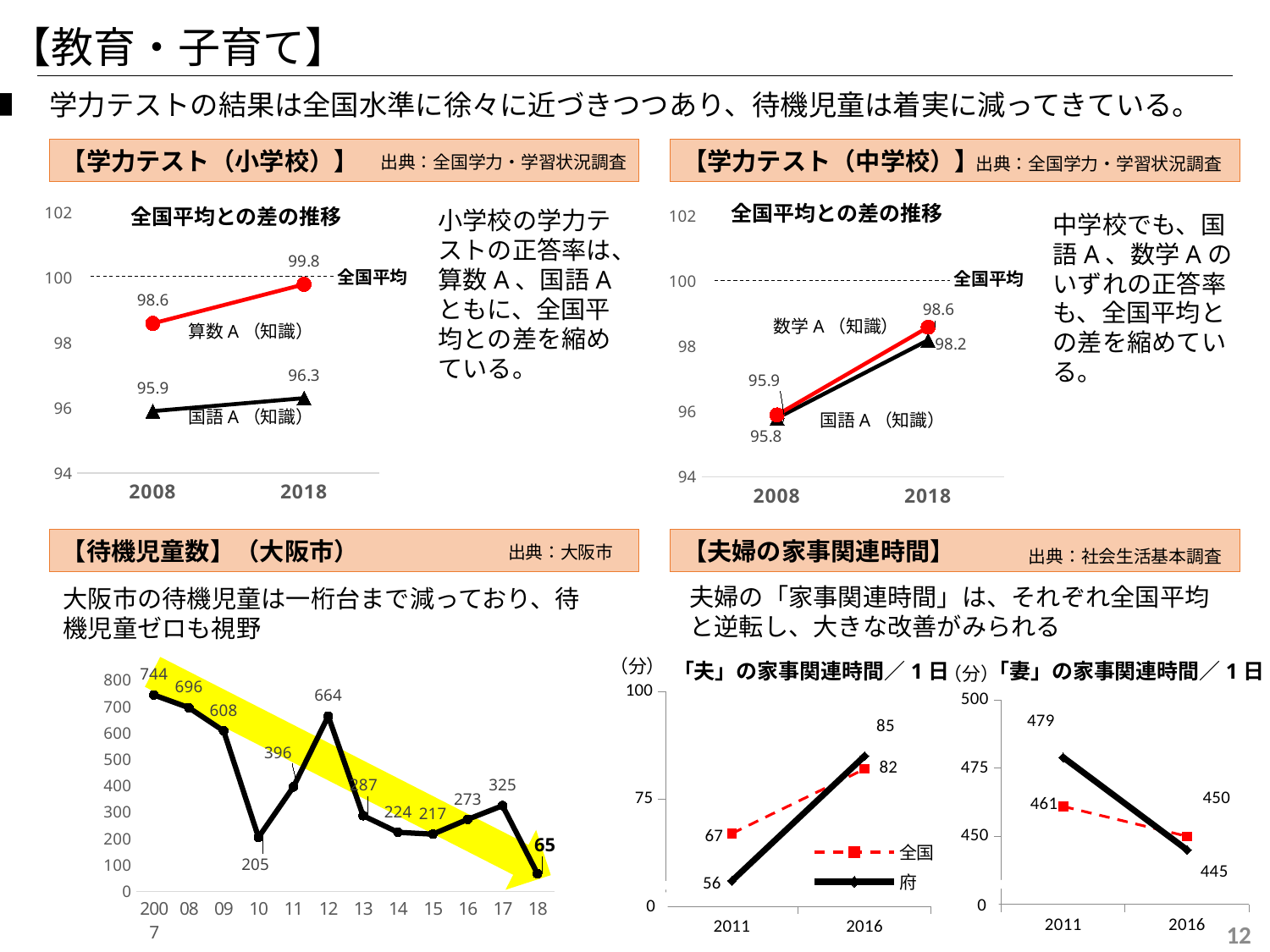
In the 【待機児童数】（大阪市） chart, which year has the highest value? 2007 In the 「夫」の家事関連時間／1日 chart, what is the value for 府 in 2016? 85 In the 「妻」の家事関連時間／1日 chart, does the 府 line rise or fall from 2011 to 2016? Fall How many data points are plotted in the 【待機児童数】（大阪市） chart? 12 In the 【学力テスト（中学校）】 chart, which is higher in 2018, 数学A（知識） or 国語A（知識）? 数学A（知識） In the 【待機児童数】（大阪市） chart, what is the difference between the 2012 value and the 2013 value? 377 In the 【待機児童数】（大阪市） chart, what is the value for 2018? 65 In the 【学力テスト（小学校）】 chart, what is the value for 算数A（知識） in 2018? 99.8 In the 【学力テスト（小学校）】 chart, by how much did 算数A（知識） increase from 2008 to 2018? 1.2 What type of chart is the 【待機児童数】（大阪市） chart? Line chart In the 【学力テスト（中学校）】 chart, what is the value for 数学A（知識） in 2018? 98.6 In the 【学力テスト（小学校）】 chart, what is the value for 国語A（知識） in 2008? 95.9